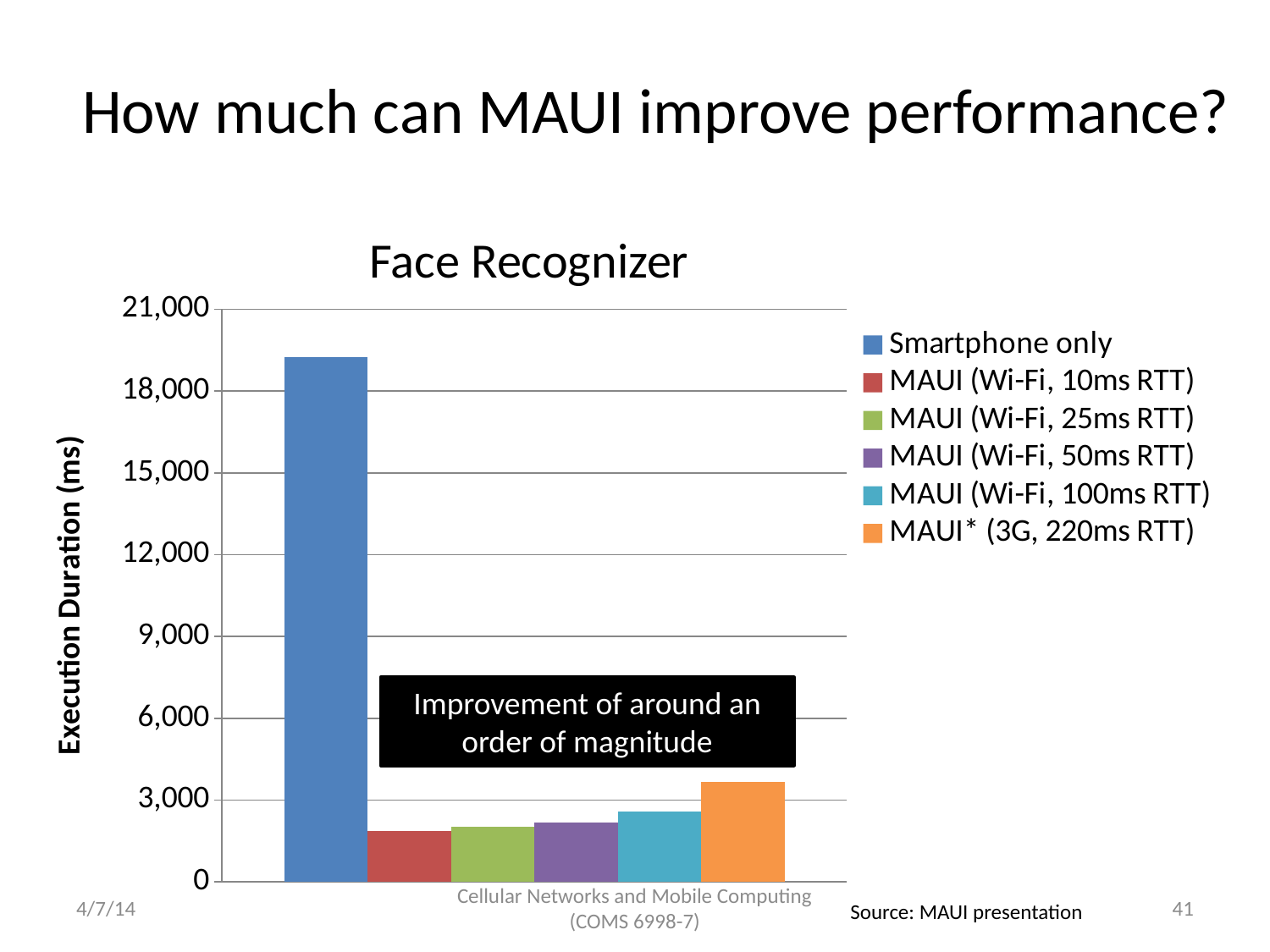
Is the value for MAUI* (3G, 220ms RTT) greater or less than 3,000? greater How many bars are plotted in the chart? 6 Which series has the highest execution duration? Smartphone only Do the execution durations of the MAUI series rise or fall as the RTT increases from left to right? rise What type of chart is shown on the slide? bar chart Is the value for Smartphone only greater or less than 18,000? greater Which is larger, the value for MAUI* (3G, 220ms RTT) or the value for MAUI (Wi-Fi, 100ms RTT)? MAUI* (3G, 220ms RTT) What is the label of the vertical axis? Execution Duration (ms) What is the title of the chart? Face Recognizer Is the value for MAUI (Wi-Fi, 10ms RTT) greater or less than 3,000? less How many series does the chart legend list? 6